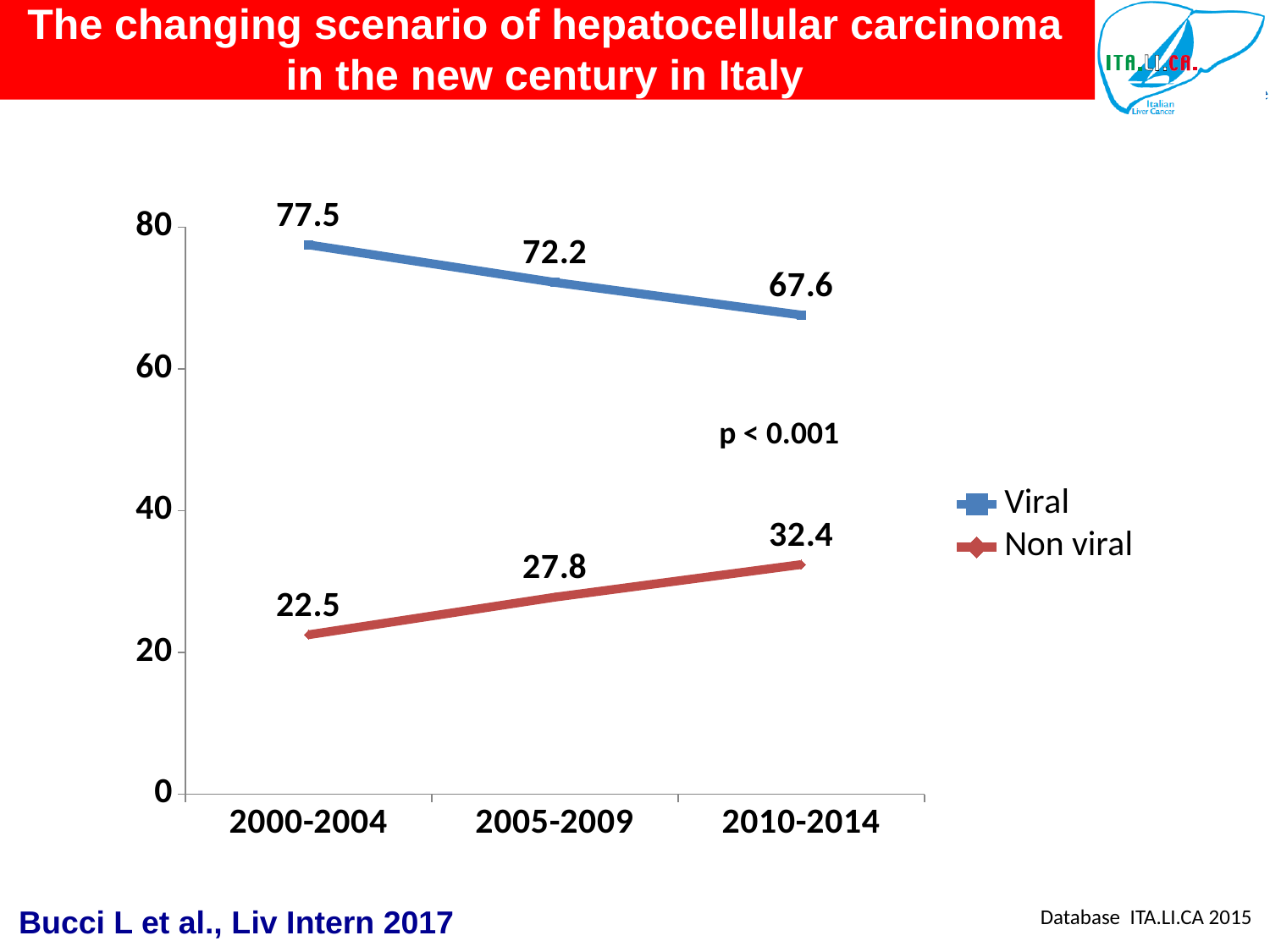
What is the value for Non viral in 2000-2004? 22.5 How many time periods are shown on the x axis? 3 What is the value for Viral in 2000-2004? 77.5 Does the Viral series rise or fall across the periods? fall What is the value for Non viral in 2010-2014? 32.4 What kind of chart is shown? line chart Which is larger in 2005-2009, Viral or Non viral? Viral In which period is the Viral value lowest? 2010-2014 In which period is the Non viral value highest? 2010-2014 What is the difference between the Viral and Non viral values in 2010-2014? 35.2 How many series does the legend list? 2 What is the value for Viral in 2005-2009? 72.2